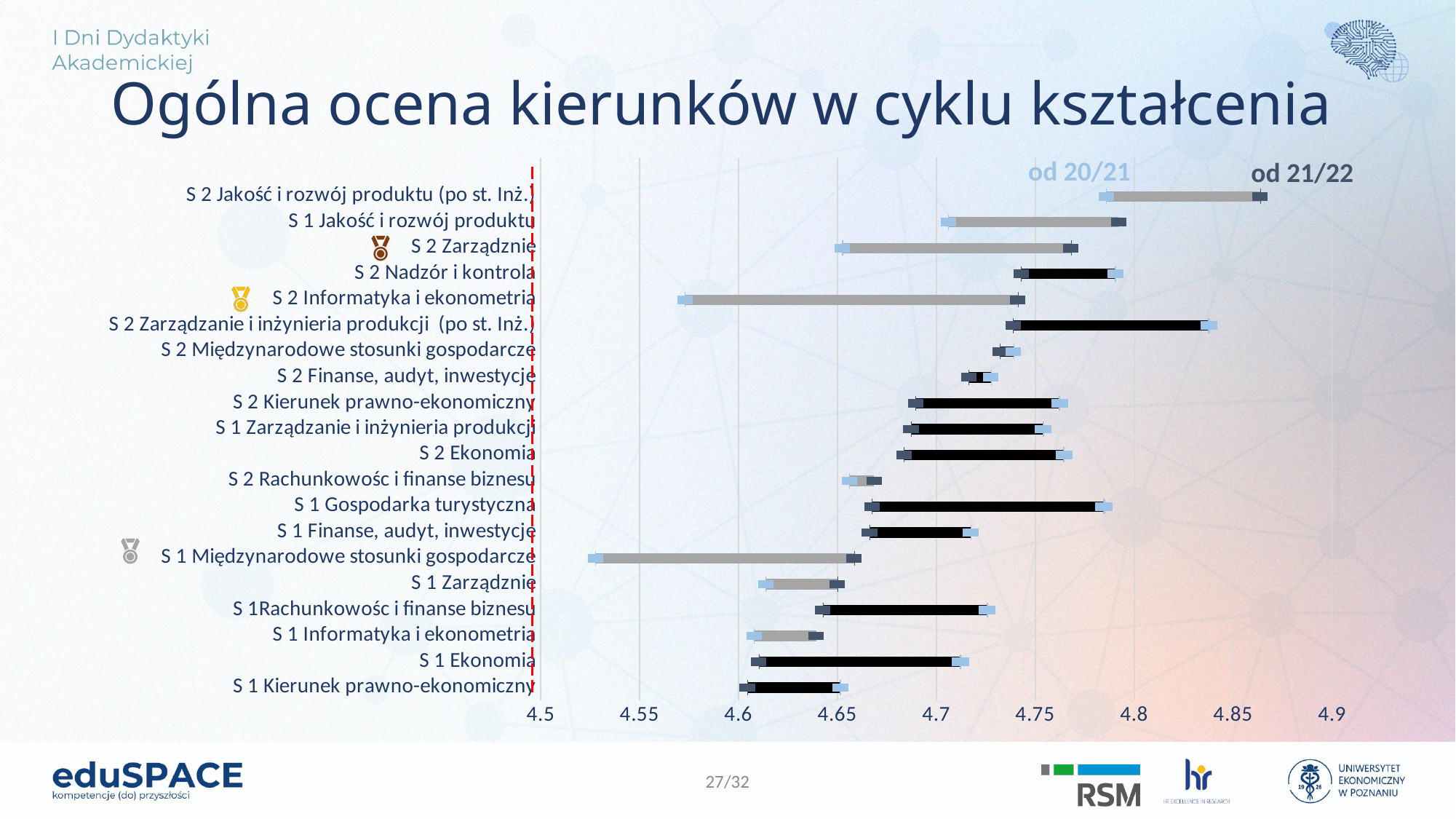
Which programme has the lowest 'od 20/21' value? S 1 Międzynarodowe stosunki gospodarcze Is the 'od 20/21' value for 'S 2 Zarządzanie i inżynieria produkcji (po st. Inż.)' greater or less than 4.8? greater What kind of chart is shown on the slide? bar chart Is the 'od 20/21' value for 'S 1 Gospodarka turystyczna' greater or less than 4.75? greater Is the 'od 21/22' value for 'S 2 Jakość i rozwój produktu (po st. Inż.)' greater or less than 4.85? greater How many series does the chart legend list? 2 What is the title of the chart on the slide? Ogólna ocena kierunków w cyklu kształcenia Which series is shown in dark navy, 'od 20/21' or 'od 21/22'? od 21/22 Which programme has the highest 'od 21/22' value? S 2 Jakość i rozwój produktu (po st. Inż.) How many study programmes (categories) are listed on the chart? 20